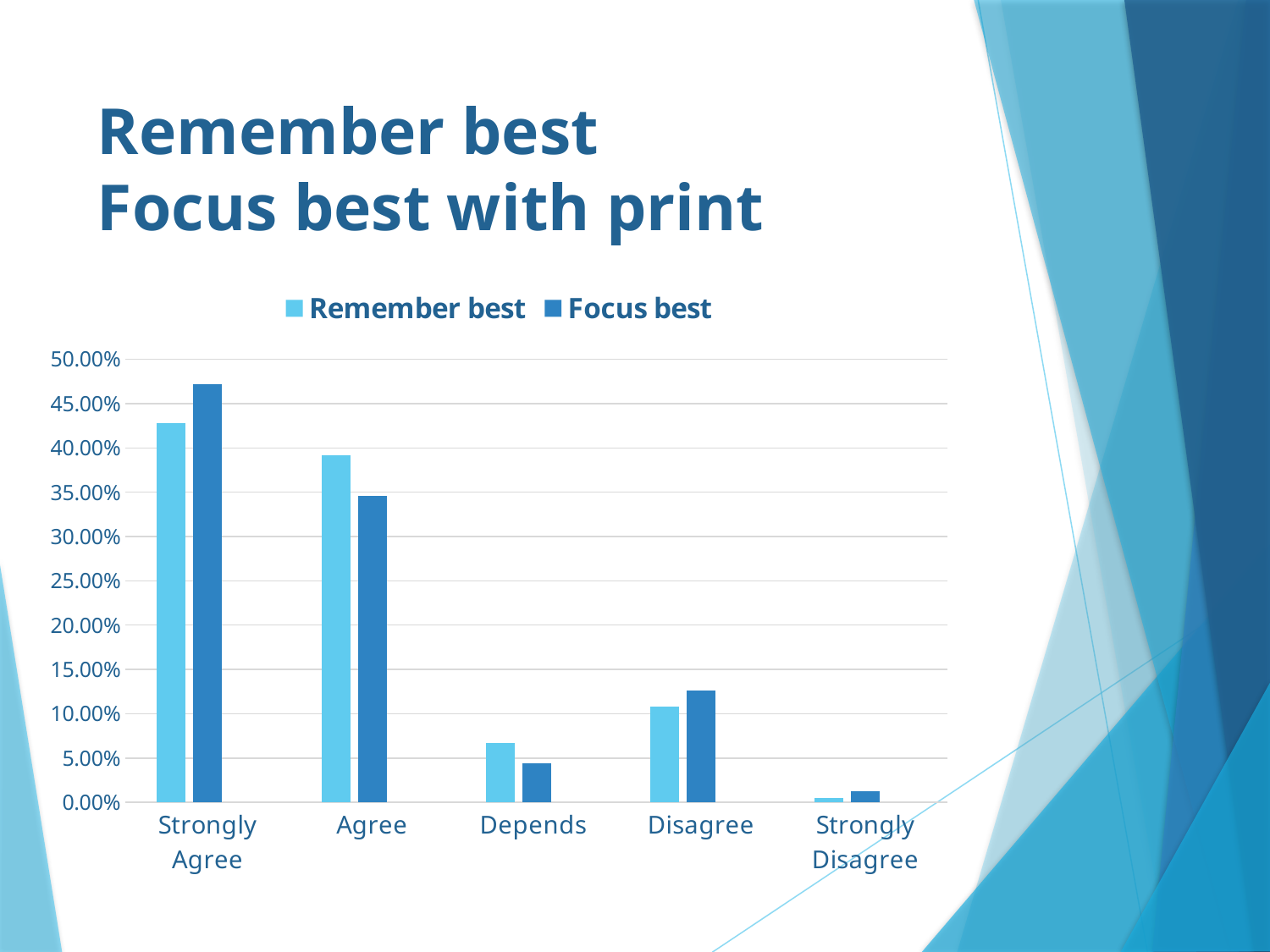
Which category has the highest value for the Remember best series? Strongly Agree For Strongly Agree, which series has the larger value, Remember best or Focus best? Focus best Is the Remember best value for Agree greater or less than 35.00%? greater What kind of chart is shown on the slide? bar chart What are the two series names listed in the legend? Remember best and Focus best For Agree, which series has the larger value, Remember best or Focus best? Remember best How many series does the legend list? 2 How many categories are shown on the x axis? 5 Which category has the highest value for the Focus best series? Strongly Agree Is the Focus best value for Strongly Agree greater or less than 45.00%? greater Which category has the lowest value for the Remember best series? Strongly Disagree Is the Focus best value for Depends greater or less than 5.00%? less